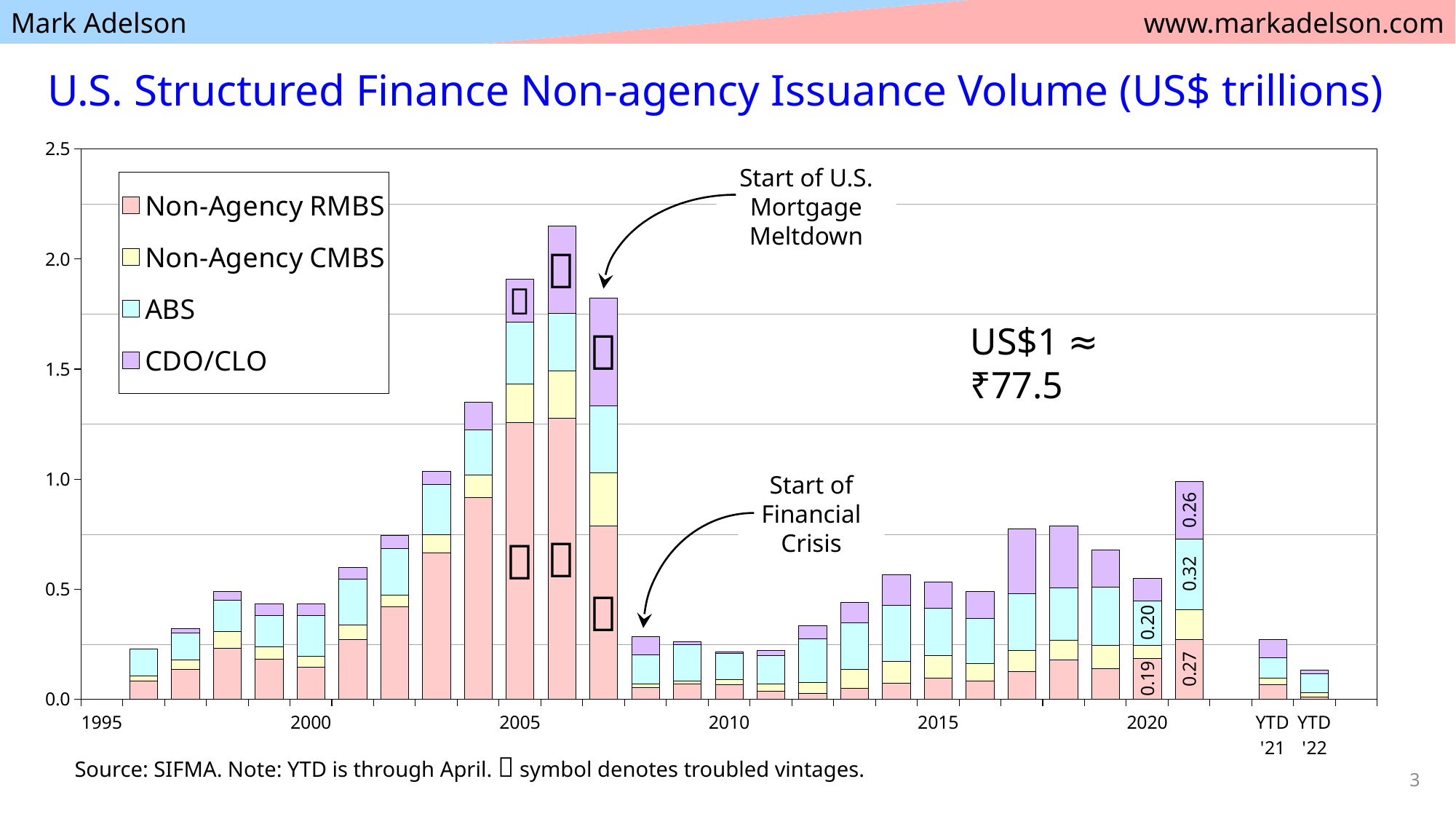
What is the CDO/CLO value for 2021? 0.26 Which year does the 'Start of U.S. Mortgage Meltdown' annotation point to? 2007 What is the ABS value for 2021? 0.32 In 2021, which is larger: the ABS value or the Non-Agency RMBS value? ABS Is the total issuance volume for 2008 greater or less than 0.5? less How many series does the legend list? 4 By how much did ABS issuance increase from 2020 to 2021? 0.12 Is the total issuance volume for 2006 greater or less than 2.0? greater Which year has the highest total issuance volume? 2006 What kind of chart is shown on the slide? Stacked bar chart What is the Non-Agency RMBS value for 2020? 0.19 By how much did Non-Agency RMBS issuance increase from 2020 to 2021? 0.08